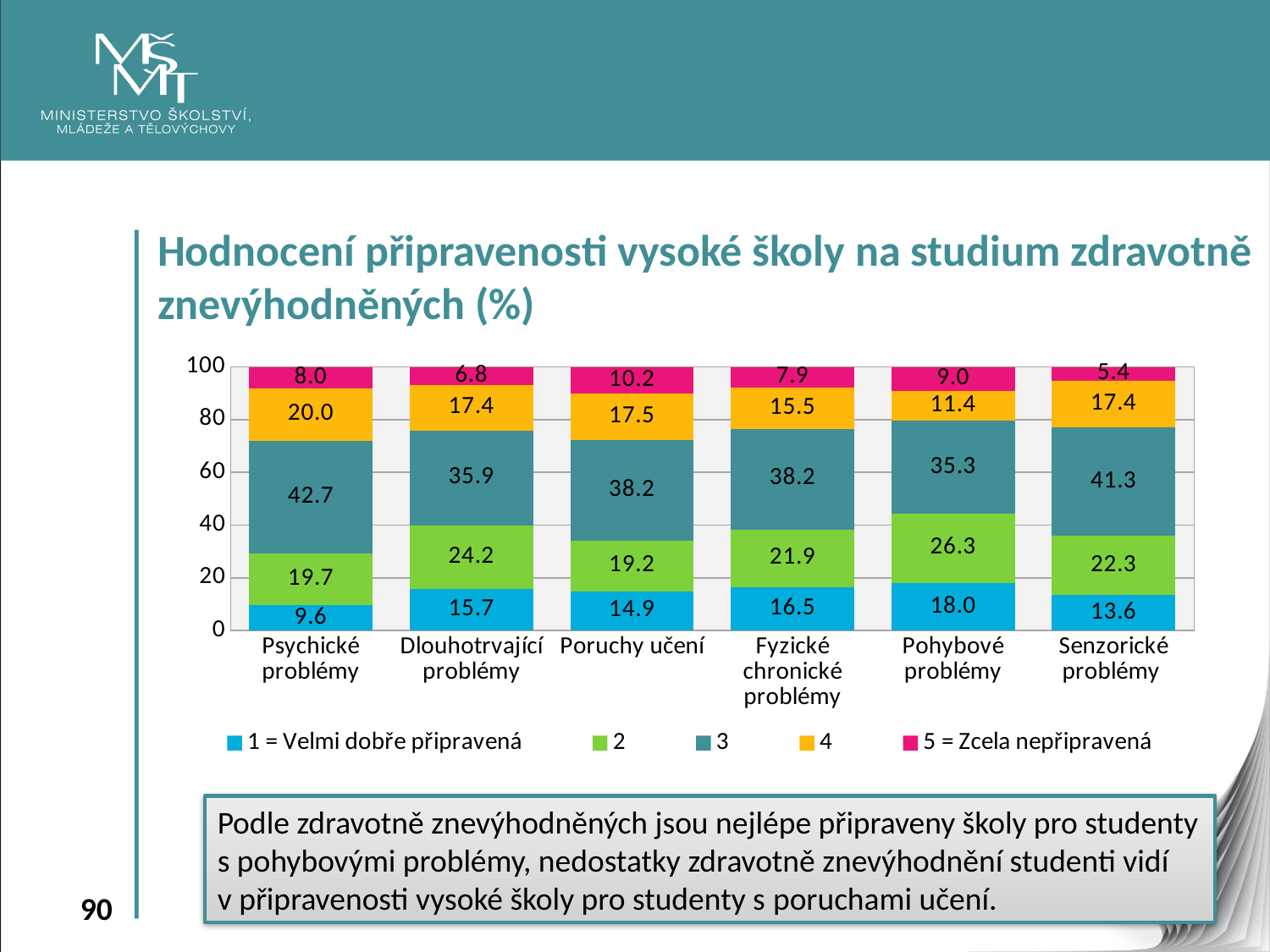
What is the value of series "1 = Velmi dobře připravená" for Pohybové problémy? 18.0 What is the value of series "3" for Senzorické problémy? 41.3 Which is larger: the series "2" value for Dlouhotrvající problémy or for Poruchy učení? Dlouhotrvající problémy What is the total of the stacked bar for Fyzické chronické problémy? 100.0 What kind of chart is shown on the slide? Stacked bar chart What is the legend label of the series shown in pink? 5 = Zcela nepřipravená How many categories are shown on the x axis? 6 Which category has the highest value for series "1 = Velmi dobře připravená"? Pohybové problémy Which category has the lowest value for series "5 = Zcela nepřipravená"? Senzorické problémy What is the difference between the series "3" values for Psychické problémy and Pohybové problémy? 7.4 What is the value of series "5 = Zcela nepřipravená" for Poruchy učení? 10.2 How many series does the legend list? 5